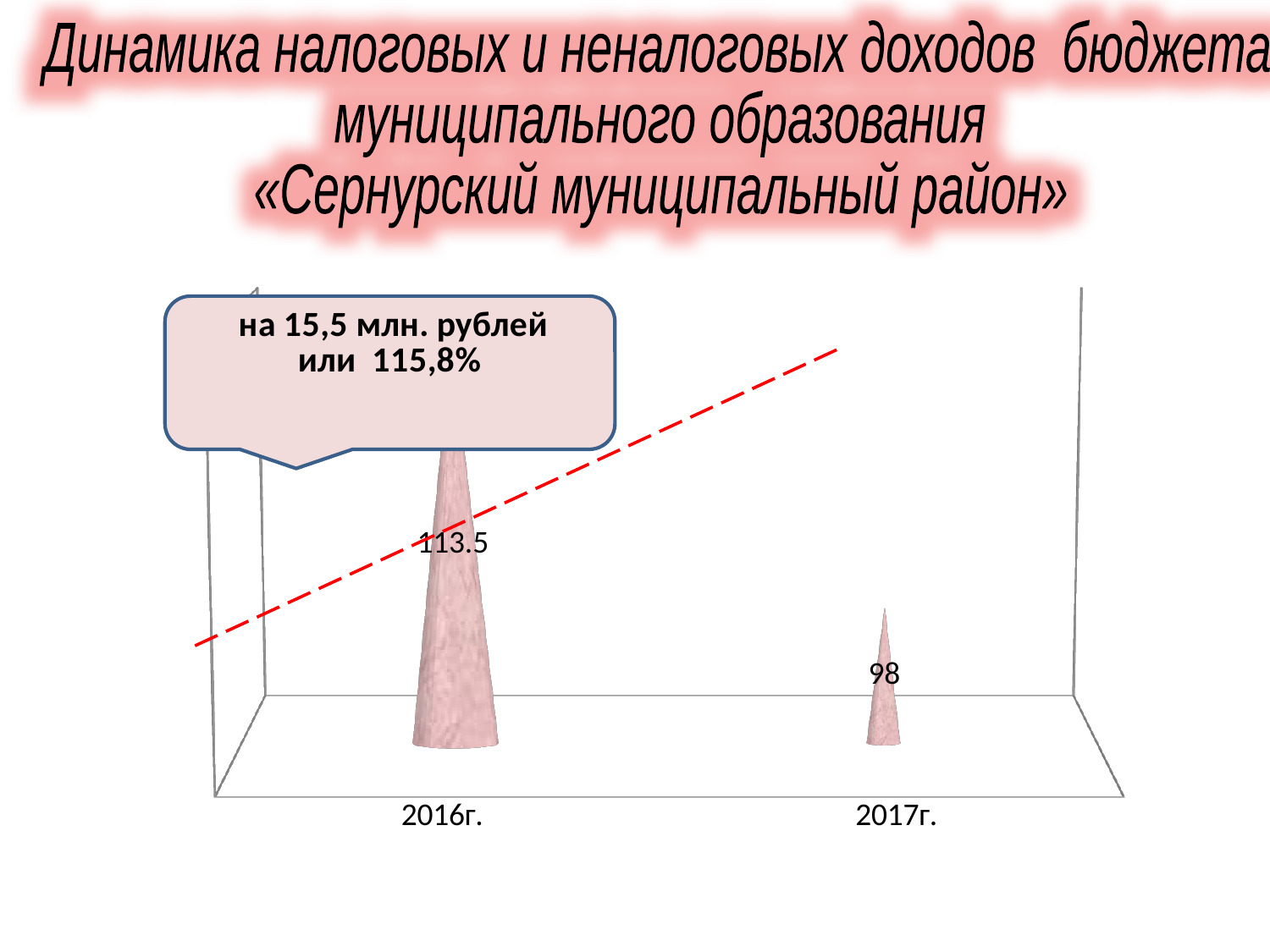
What amount in million rubles is stated in the callout box on the chart? 15,5 млн. рублей What is the value shown for 2016г.? 113.5 What percentage is stated in the callout box on the chart? 115,8% What kind of chart is shown on the slide? bar chart How many categories are plotted on the chart? 2 Which year has the lower value? 2017г. Is the value for 2016г. larger or smaller than the value for 2017г.? larger What is the difference between the values for 2016г. and 2017г.? 15.5 Which year has the higher value? 2016г. What is the value shown for 2017г.? 98 Do the plotted values rise or fall from 2016г. to 2017г.? fall